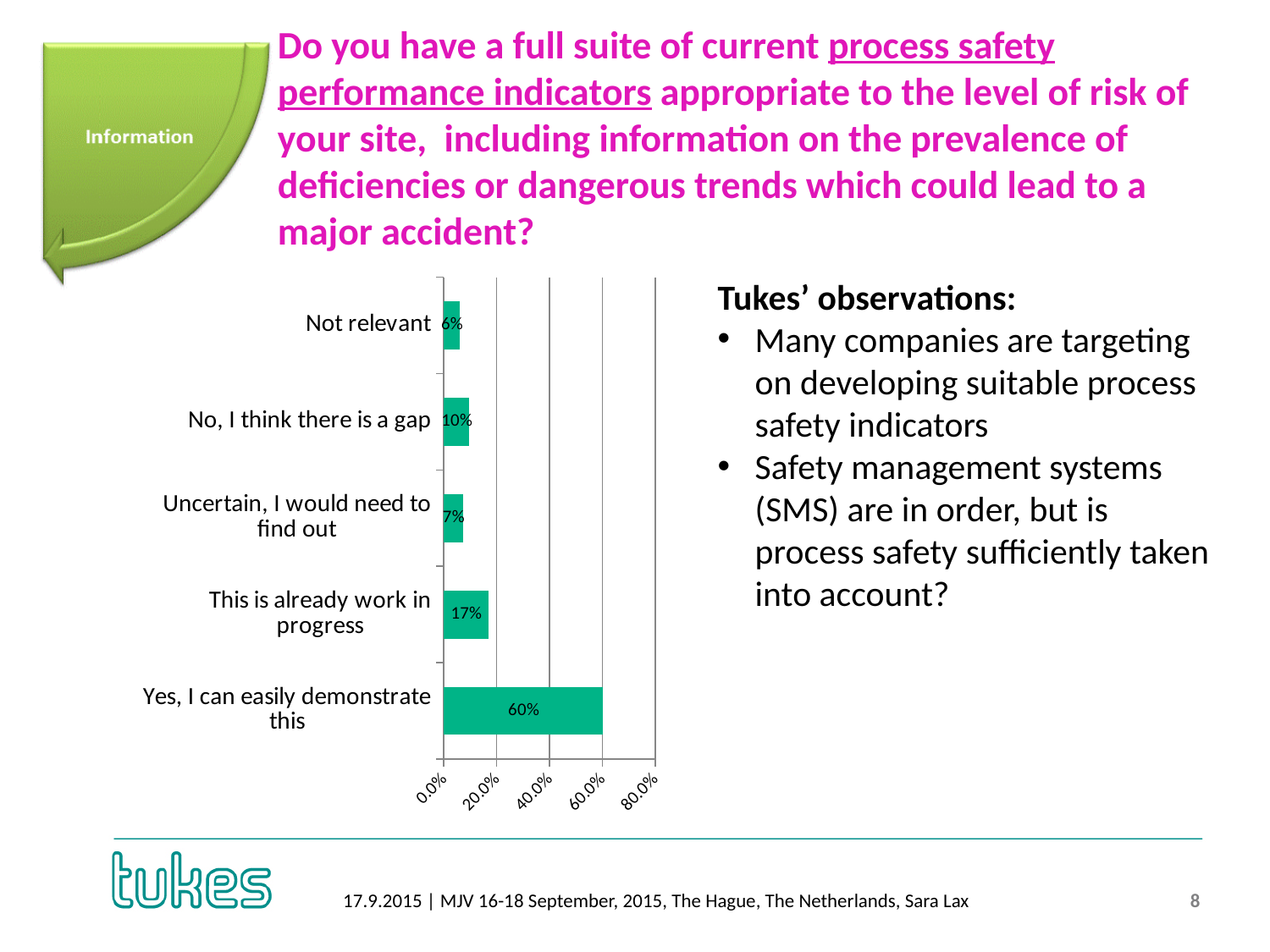
Which response category has the lowest value? Not relevant What type of chart is shown on the slide? Bar chart How many response categories are shown in the chart? 5 What percentage of respondents answered "Yes, I can easily demonstrate this"? 60% What is the value for "Uncertain, I would need to find out"? 7% What is the value for "This is already work in progress"? 17% What is the value for "Not relevant"? 6% Is the value for "Yes, I can easily demonstrate this" greater or less than 40.0%? greater What is the difference between "Yes, I can easily demonstrate this" and "This is already work in progress"? 43% What is the value for "No, I think there is a gap"? 10% Which is larger: "No, I think there is a gap" or "Uncertain, I would need to find out"? No, I think there is a gap Which response category has the highest value? Yes, I can easily demonstrate this